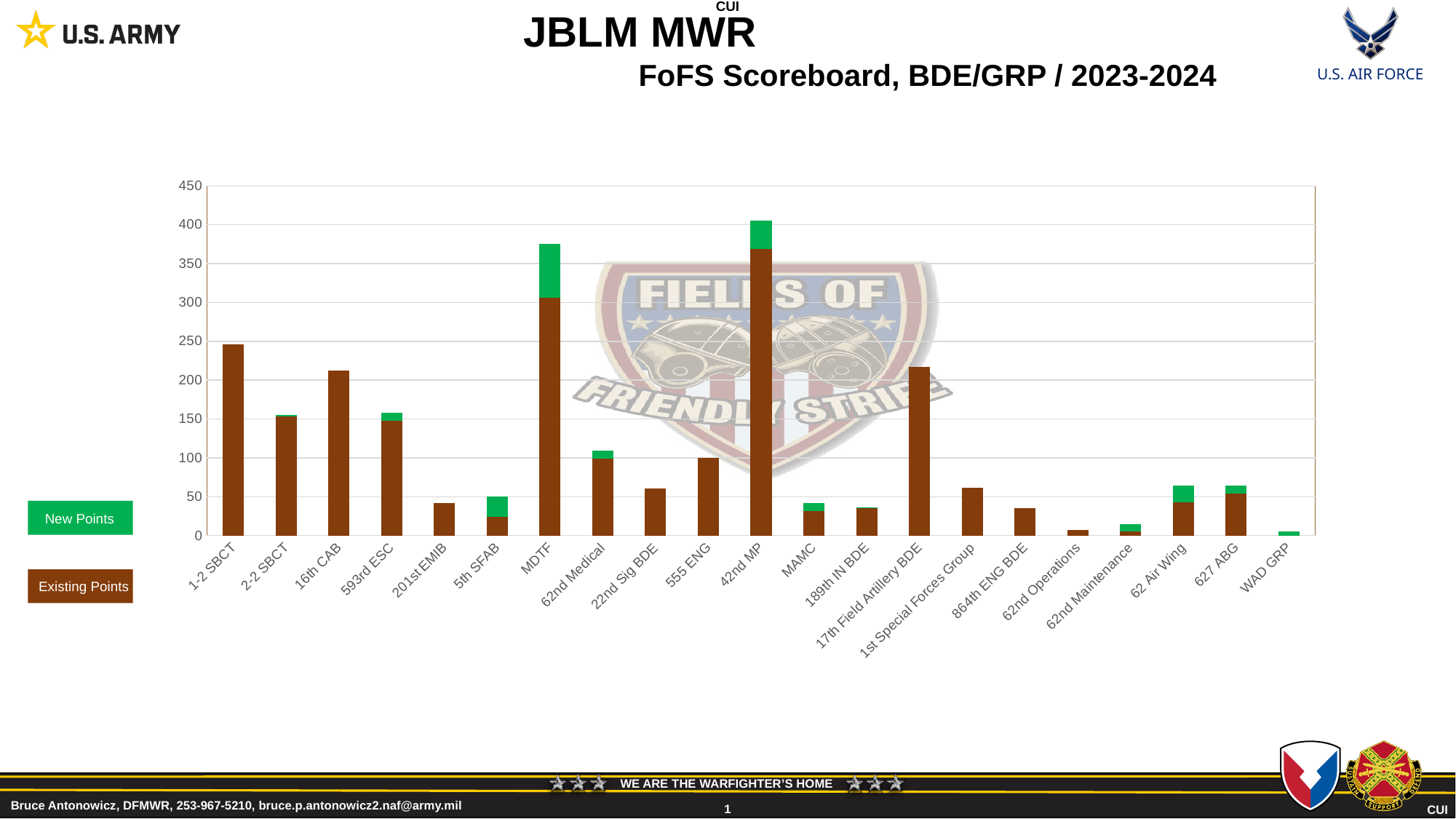
Which colour represents New Points in the chart? green Which has the larger total bar, 1-2 SBCT or 16th CAB? 1-2 SBCT What is the title of the scoreboard shown on the slide? FoFS Scoreboard, BDE/GRP / 2023-2024 How many series does the chart's legend list? 2 Is the total value for 1-2 SBCT greater or less than 200? greater Is the total value for MDTF greater or less than 350? greater How many categories (units) are shown along the x axis of the chart? 21 What kind of chart is shown on the slide? bar chart Which unit has the highest total bar in the chart? 42nd MP Which has the larger total bar, 62 Air Wing or 864th ENG BDE? 62 Air Wing Is the total value for 17th Field Artillery BDE greater or less than 200? greater